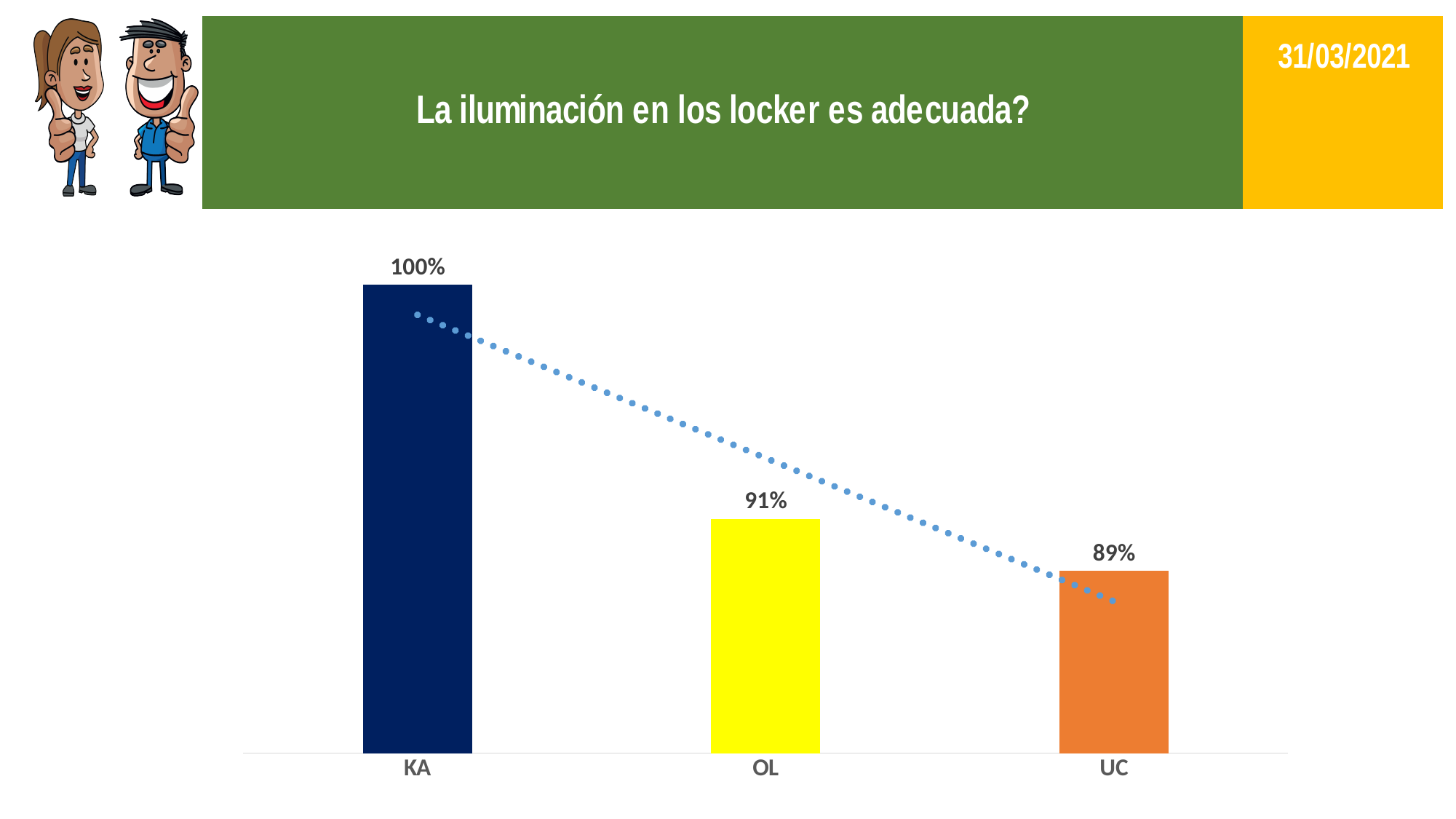
What is the value for OL? 91% What kind of chart is this? bar chart What is the difference between the values for KA and UC? 11% How many categories are shown on the x axis? 3 What is the value for KA? 100% What colour is the bar for OL? yellow What is the difference between the values for OL and UC? 2% Which is larger, the value for KA or the value for OL? KA Which category has the highest value? KA Which category has the lowest value? UC Do the values rise or fall from KA to UC? fall What is the value for UC? 89%